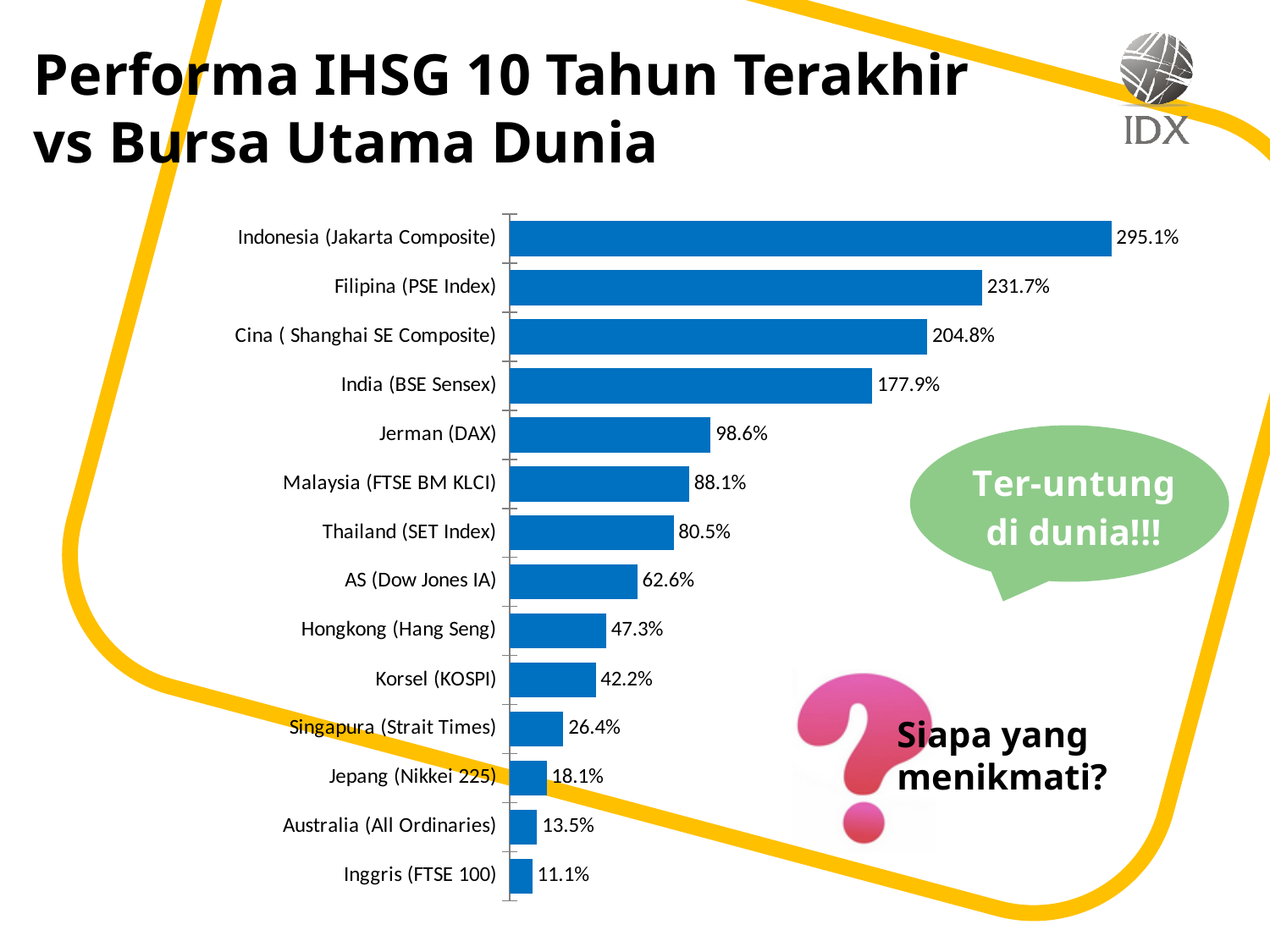
Which category has the highest value? Indonesia (Jakarta Composite) Which category has the lowest value? Inggris (FTSE 100) What is the title of the slide? Performa IHSG 10 Tahun Terakhir vs Bursa Utama Dunia What is the value for Singapura (Strait Times)? 26.4% What is the value for Jerman (DAX)? 98.6% Which is larger, the value for Thailand (SET Index) or the value for AS (Dow Jones IA)? Thailand (SET Index) What is the difference between the values for India (BSE Sensex) and Jerman (DAX)? 79.3% What kind of chart is shown on the slide? Bar chart How many categories are shown in the chart? 14 What is the value for Indonesia (Jakarta Composite)? 295.1% Which is larger, the value for Hongkong (Hang Seng) or the value for Korsel (KOSPI)? Hongkong (Hang Seng) What is the difference between the values for Filipina (PSE Index) and Cina ( Shanghai SE Composite)? 26.9%